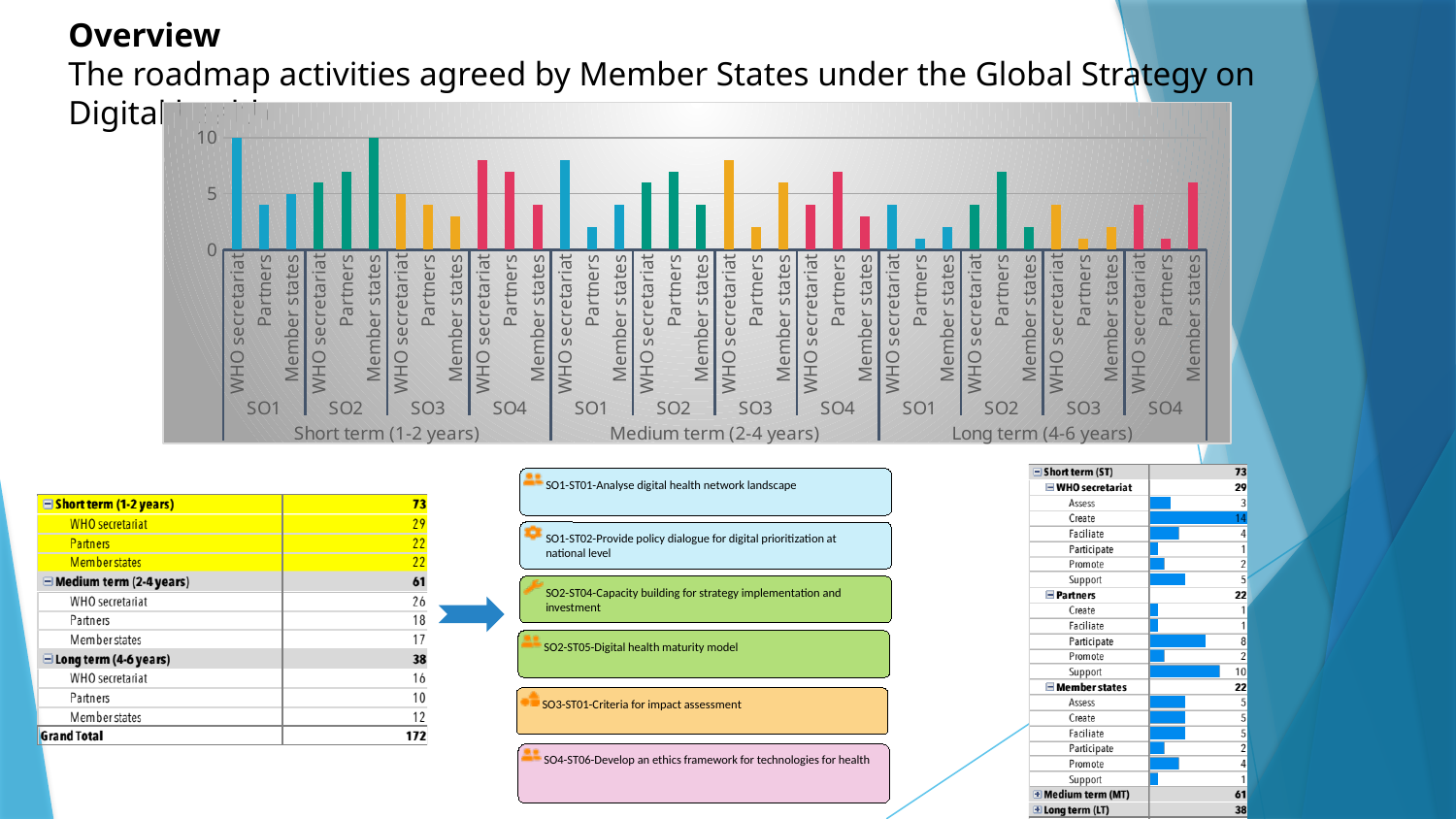
In the top chart, is the value for Partners under SO1 in the Short term (1-2 years) group greater or less than 5? less How many time-horizon groups (Short term, Medium term, Long term) are shown along the x axis of the top chart? 3 In the top chart, is the value for Partners under SO1 in the Long term (4-6 years) group greater or less than 5? less In the top chart, under SO3 in the Medium term (2-4 years) group, which is larger: WHO secretariat or Member states? WHO secretariat In the top chart, within SO3 of the Short term (1-2 years) group, which category has the lowest bar? Member states What kind of chart is shown at the top of the slide? bar chart In the top chart, under SO1 in the Medium term (2-4 years) group, which is larger: WHO secretariat or Partners? WHO secretariat How many strategic objectives (SO1 to SO4) are shown within each time-horizon group in the top chart? 4 In the top chart, what is the value for WHO secretariat under SO1 in the Short term (1-2 years) group? 10 In the top chart, within SO2 of the Long term (4-6 years) group, which category has the highest bar? Partners What is the highest tick value shown on the y axis of the top chart? 10 In the top chart, is the value for WHO secretariat under SO4 in the Short term (1-2 years) group greater or less than 5? greater